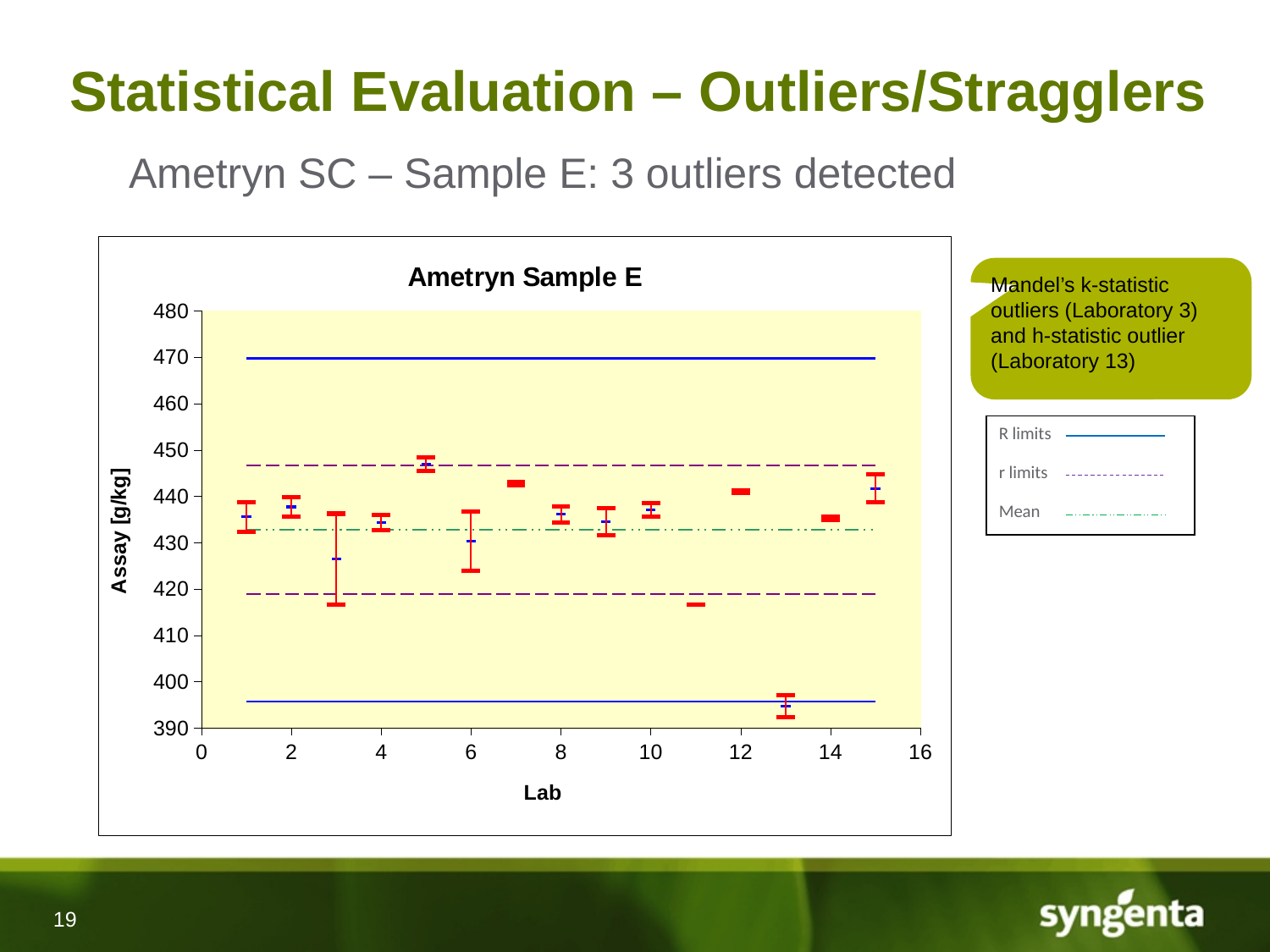
How many series does the chart legend list? 3 Which lab has the lowest assay value in the chart? Lab 13 Is the assay value for Lab 13 greater or less than 400? less What kind of chart is shown on the slide? scatter chart with error bars Which has the larger assay value, Lab 11 or Lab 13? Lab 11 What is the label of the y axis of the chart? Assay [g/kg] Is the assay value for Lab 3 greater or less than 430? less Is the assay value for Lab 11 greater or less than 420? less What is the title of the chart? Ametryn Sample E How many labs are plotted in the chart? 15 Which has the larger assay value, Lab 5 or Lab 3? Lab 5